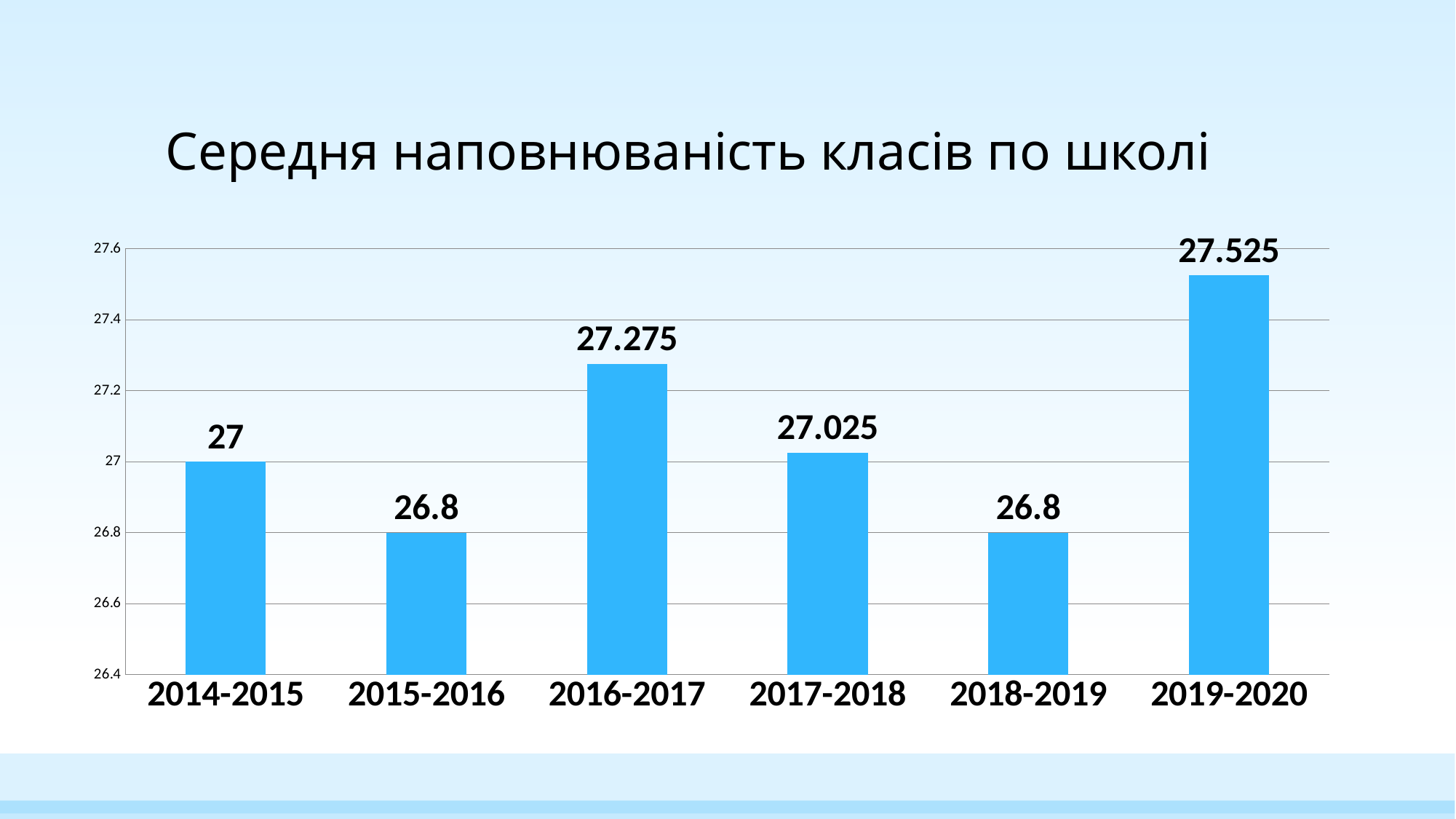
What is the value for 2019-2020? 27.525 What is the title of the chart? Середня наповнюваність класів по школі Which school years share the lowest value? 2015-2016 and 2018-2019 What is the value for 2014-2015? 27 Which is larger, the value for 2016-2017 or the value for 2017-2018? 2016-2017 What is the difference between the values for 2019-2020 and 2016-2017? 0.25 Which school year has the highest value? 2019-2020 Is the value for 2018-2019 greater or less than 27? less What is the value for 2017-2018? 27.025 What kind of chart is shown on the slide? bar chart What is the value for 2016-2017? 27.275 How many school years are shown on the chart? 6